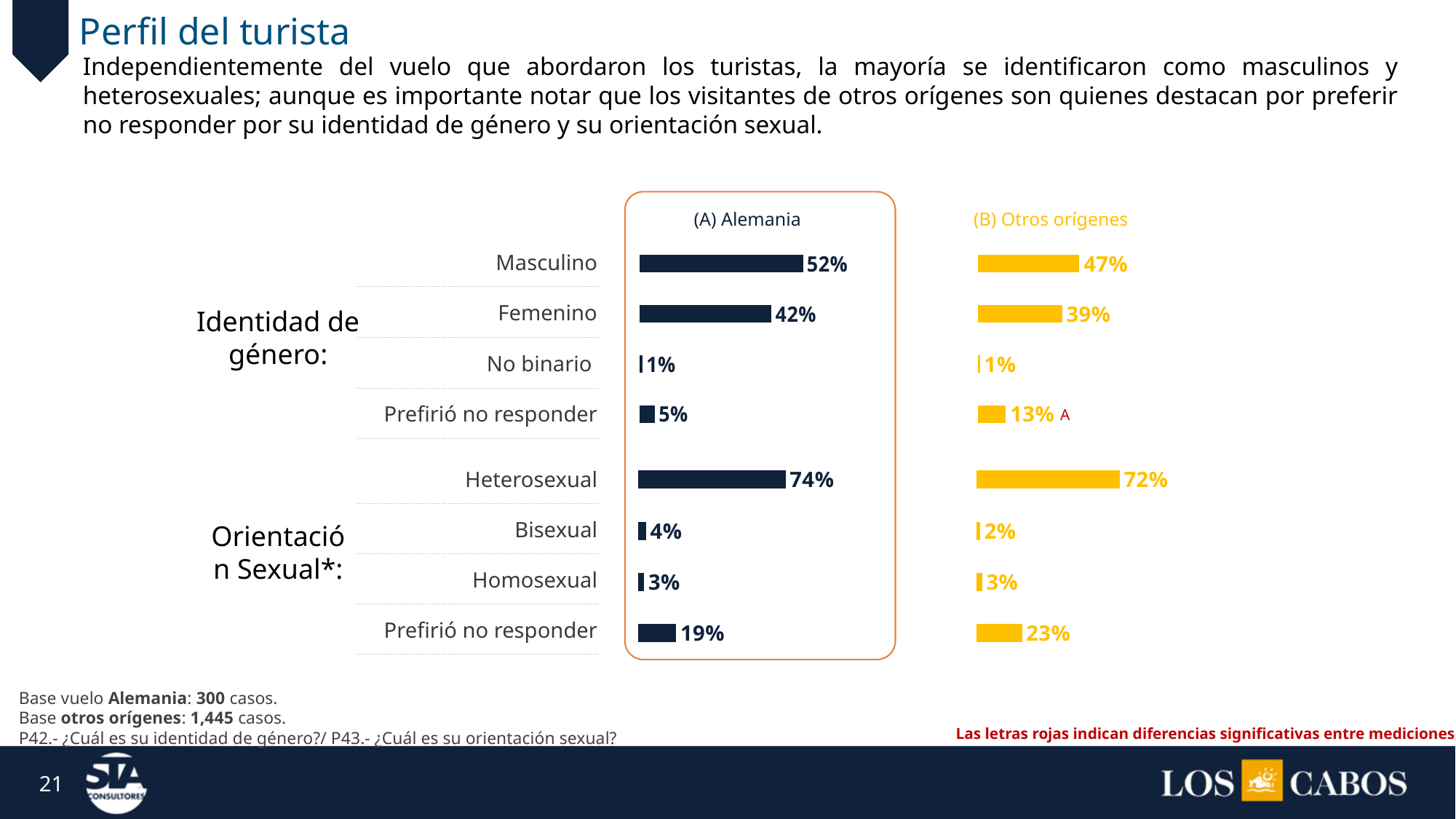
What colour are the bars for the (B) Otros orígenes series? Yellow What percentage of Alemania tourists identified as Masculino? 52% What percentage of Otros orígenes tourists identified as Femenino? 39% Which sexual orientation category has the highest value for Otros orígenes? Heterosexual What is the difference between the Alemania and Otros orígenes values for Masculino? 5% Which is larger for Bisexual: the Alemania value or the Otros orígenes value? Alemania What percentage of Otros orígenes tourists preferred not to answer about their gender identity (Prefirió no responder under Identidad de género)? 13% What is the difference between the Otros orígenes and Alemania values for Prefirió no responder under Orientación Sexual? 4% What kind of chart is used on this slide? Bar chart What percentage of Alemania tourists identified as Heterosexual? 74% Which gender identity category has the lowest value for Alemania? No binario